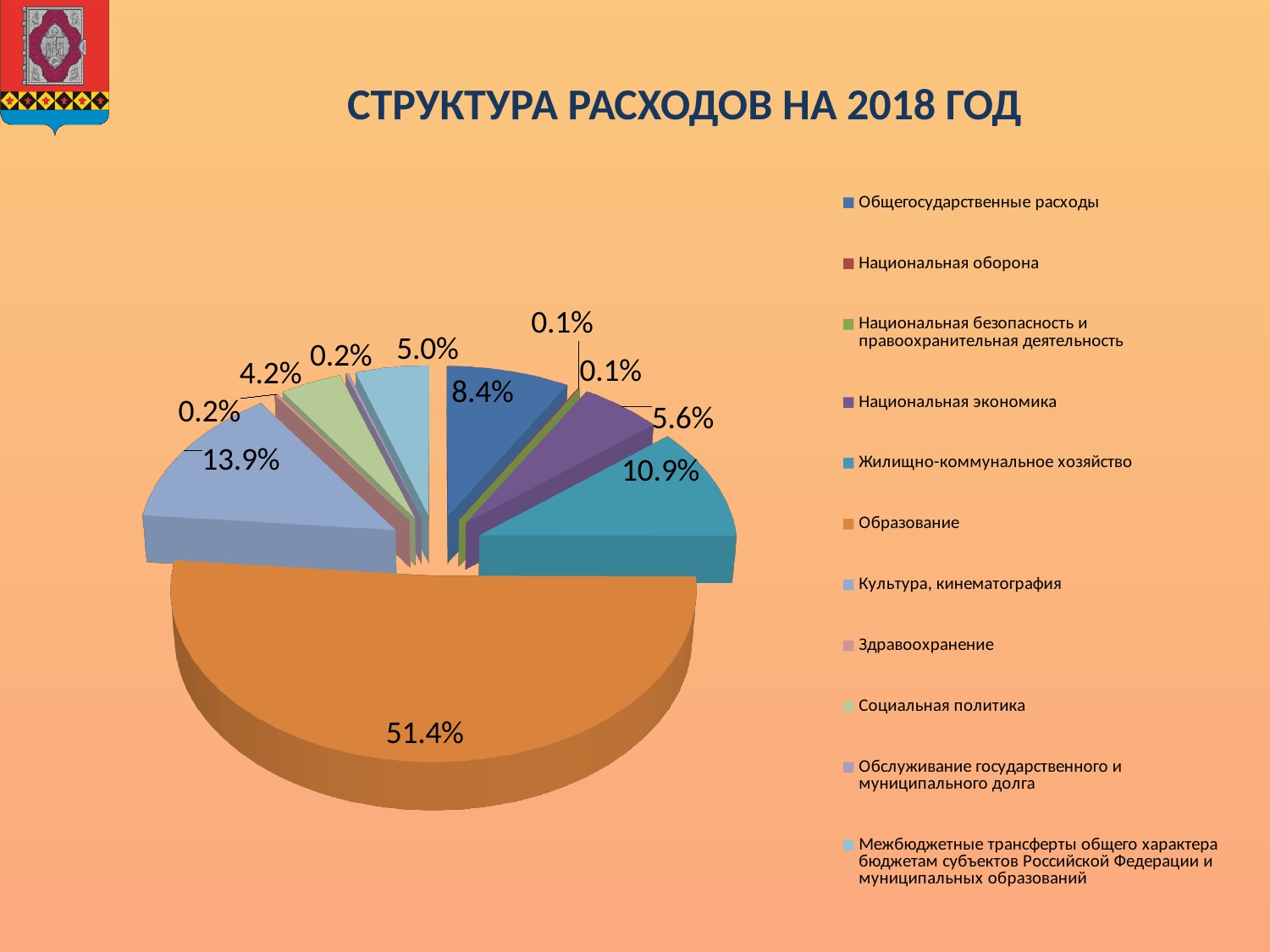
What is the difference between the share for Культура, кинематография and the share for Общегосударственные расходы? 5.5% What share of expenditures goes to Общегосударственные расходы? 8.4% Which is larger: the share for Национальная экономика or the share for Жилищно-коммунальное хозяйство? Жилищно-коммунальное хозяйство What share of expenditures goes to Социальная политика? 4.2% What is the title of the chart? СТРУКТУРА РАСХОДОВ НА 2018 ГОД What kind of chart is shown on the slide? pie chart How many categories does the legend list? 11 What share of expenditures goes to Жилищно-коммунальное хозяйство? 10.9% Which category has the largest share of expenditures? Образование What share of expenditures goes to Культура, кинематография? 13.9% What is the combined share of Образование and Культура, кинематография? 65.3% What share of expenditures goes to Образование? 51.4%